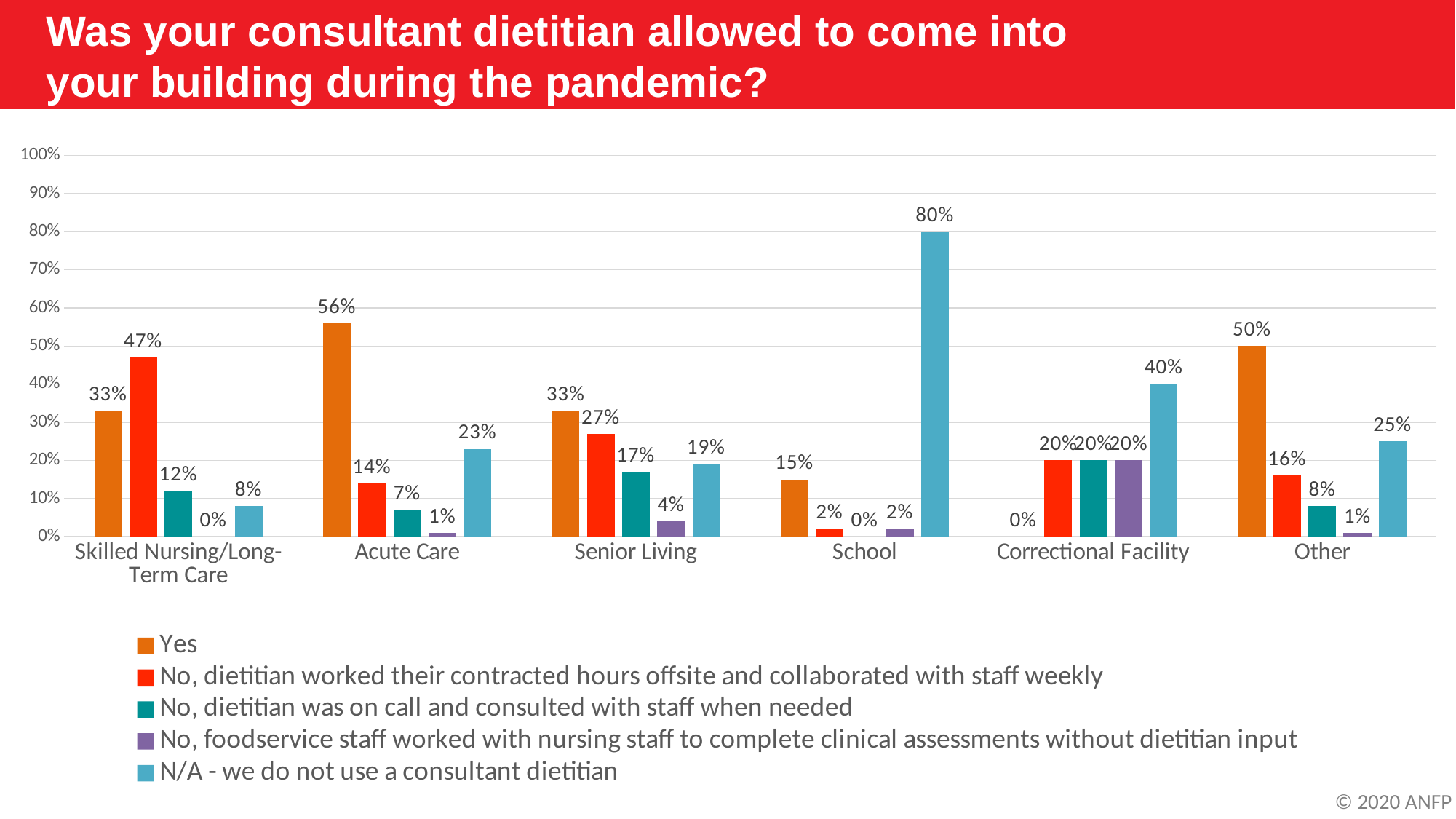
Which is larger for Senior Living: the "Yes" value or the "No, dietitian worked their contracted hours offsite and collaborated with staff weekly" value? Yes How many series does the legend list? 5 Which category has the highest "Yes" value? Acute Care What is the difference between the "Yes" values for Other and Senior Living? 17% What percentage of Acute Care respondents answered "Yes"? 56% What is the title of the chart? Was your consultant dietitian allowed to come into your building during the pandemic? What kind of chart is shown on the slide? Bar chart What is the value of the "N/A - we do not use a consultant dietitian" bar for School? 80% Which category has the lowest "N/A - we do not use a consultant dietitian" value? Skilled Nursing/Long-Term Care What is the "Yes" value for Correctional Facility? 0% What percentage of Skilled Nursing/Long-Term Care respondents said their dietitian worked their contracted hours offsite and collaborated with staff weekly? 47% How many categories are shown on the x axis? 6